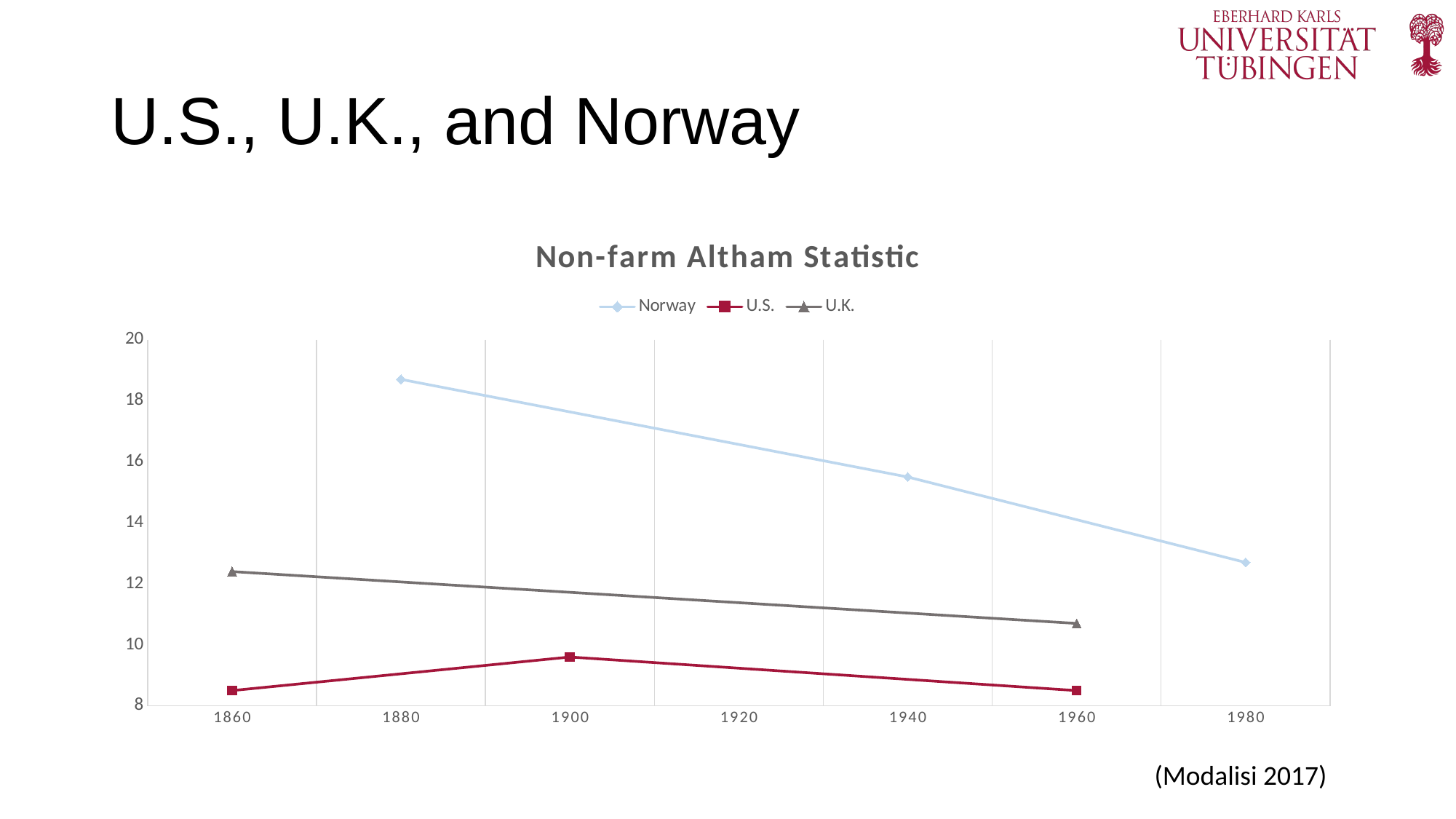
Is the value for Norway in 1980 greater or less than 14? less How many data points are plotted for Norway? 3 Is the value for the U.K. in 1860 greater or less than 12? greater How many series does the legend list? 3 Is the value for the U.S. in 1900 greater or less than 10? less Do the values for Norway rise or fall from 1880 to 1980? fall What is the title of the chart? Non-farm Altham Statistic What kind of chart is shown on the slide? line chart Which is larger: the value for Norway in 1940 or the value for the U.K. in 1960? Norway in 1940 Which series has the lowest values on the chart? U.S. Which series has the highest value on the chart? Norway